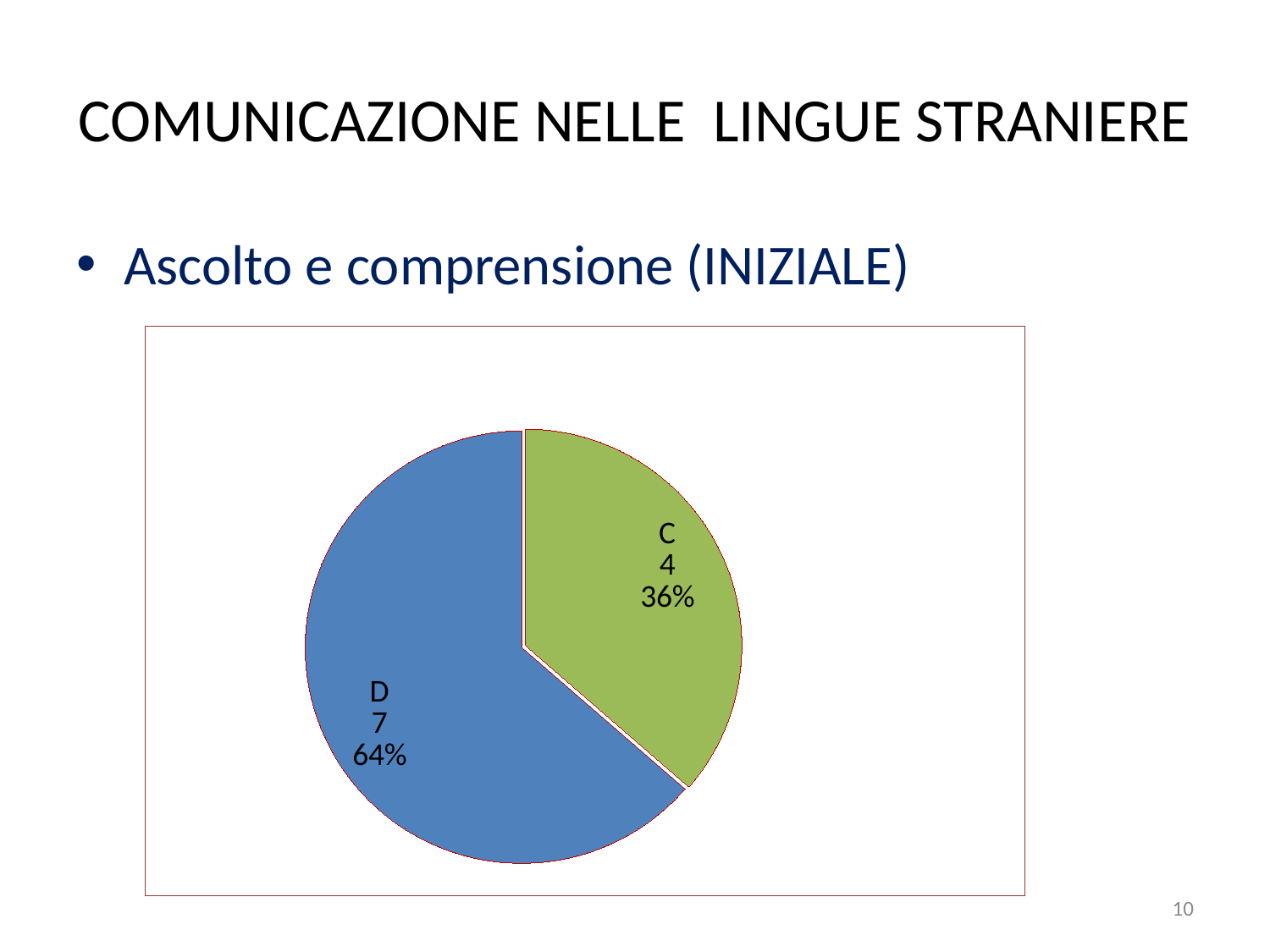
What is the total of the values of all slices? 11 What is the value for slice C? 4 What is the difference between the values of D and C? 3 What is the value for slice D? 7 What colour is the slice for D? blue Which is larger, the value for C or the value for D? D How many slices does the pie chart have? 2 What share of the pie does slice D represent? 64% What kind of chart is shown on the slide? pie chart What share of the pie does slice C represent? 36% Which slice is the smallest? C Which slice is the largest? D